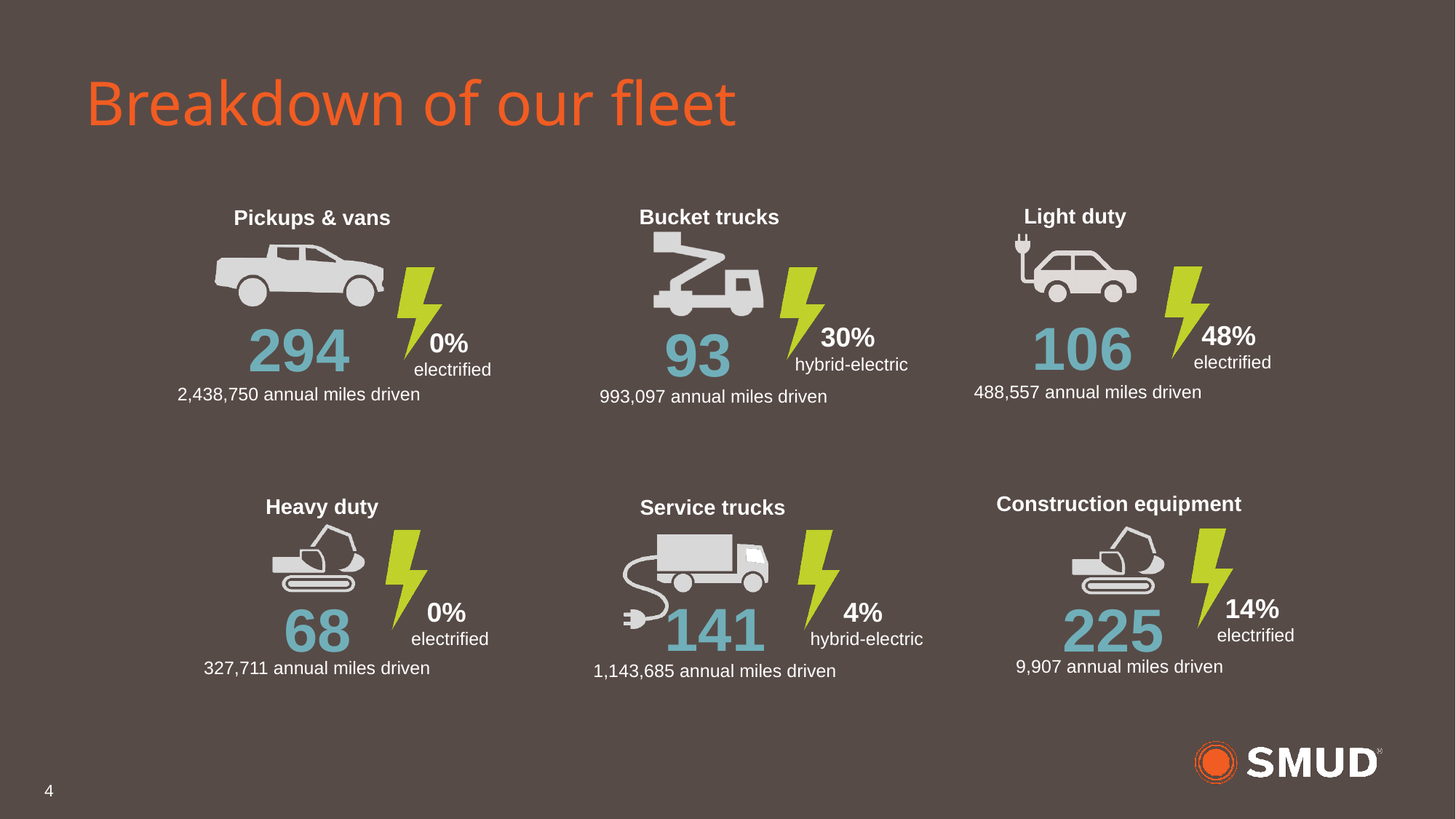
Which vehicle category has the fewest vehicles? Heavy duty What percentage of construction equipment is electrified? 14% What percentage of bucket trucks are hybrid-electric? 30% Which vehicle category has the fewest annual miles driven? Construction equipment Which has more vehicles, construction equipment or light duty? Construction equipment Which vehicle category has the largest number of vehicles? Pickups & vans Which vehicle category has the highest electrified or hybrid-electric percentage? Light duty What is the difference between the number of service trucks and the number of bucket trucks? 48 What is the title of the slide? Breakdown of our fleet How many vehicle categories are shown on the slide? 6 How many annual miles are driven by light duty vehicles? 488,557 How many pickups & vans are in the fleet? 294